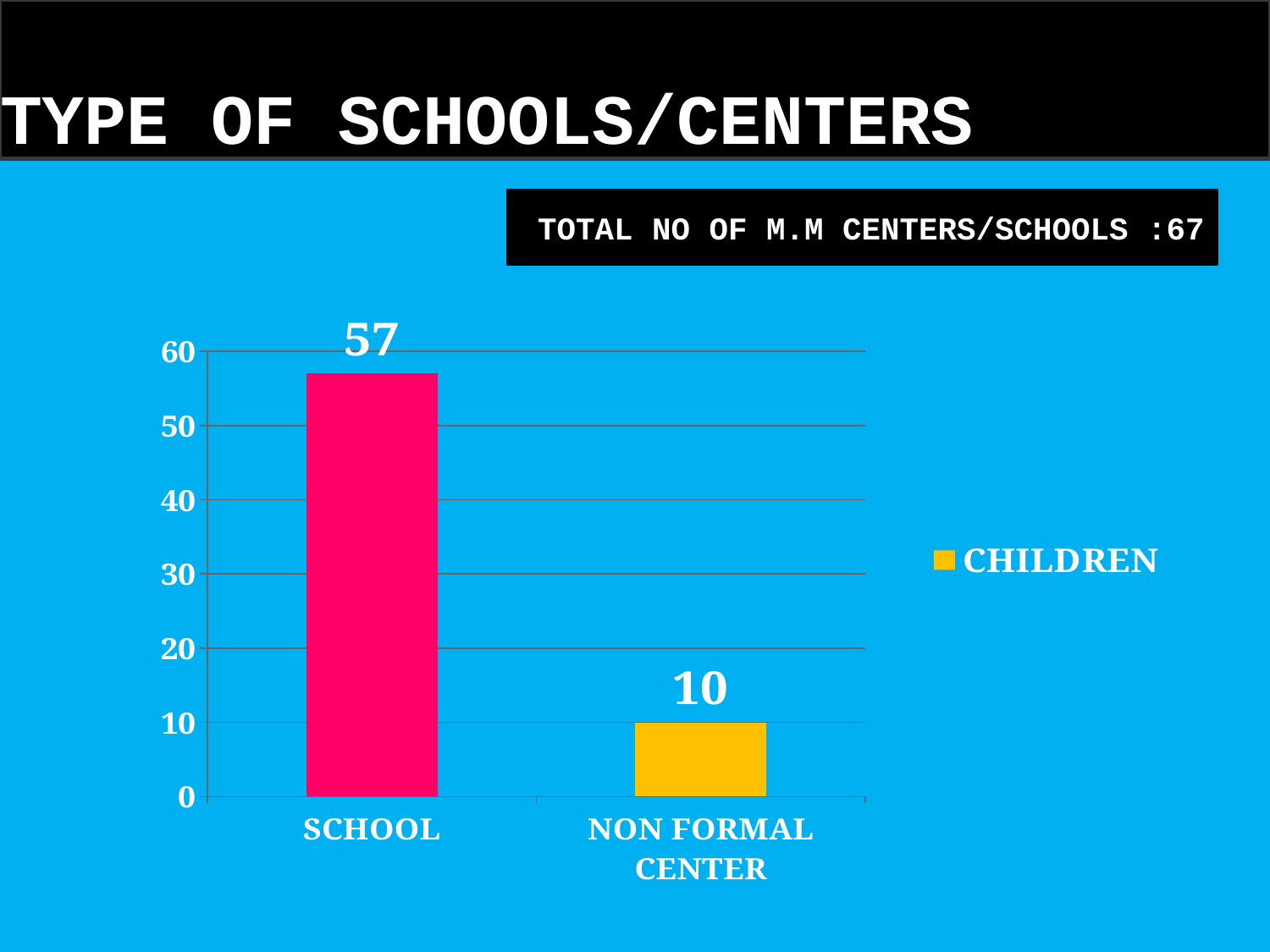
Which category has the highest value? SCHOOL Which category has the lowest value? NON FORMAL CENTER How many categories are shown on the x axis? 2 How many series does the legend list? 1 What kind of chart is shown on the slide? bar chart What is the difference between the values for SCHOOL and NON FORMAL CENTER? 47 What is the value for NON FORMAL CENTER? 10 Which is larger, the value for SCHOOL or the value for NON FORMAL CENTER? SCHOOL What series name is shown in the legend? CHILDREN Is the value for NON FORMAL CENTER greater or less than 20? less What is the value for SCHOOL? 57 Is the value for SCHOOL greater or less than 50? greater